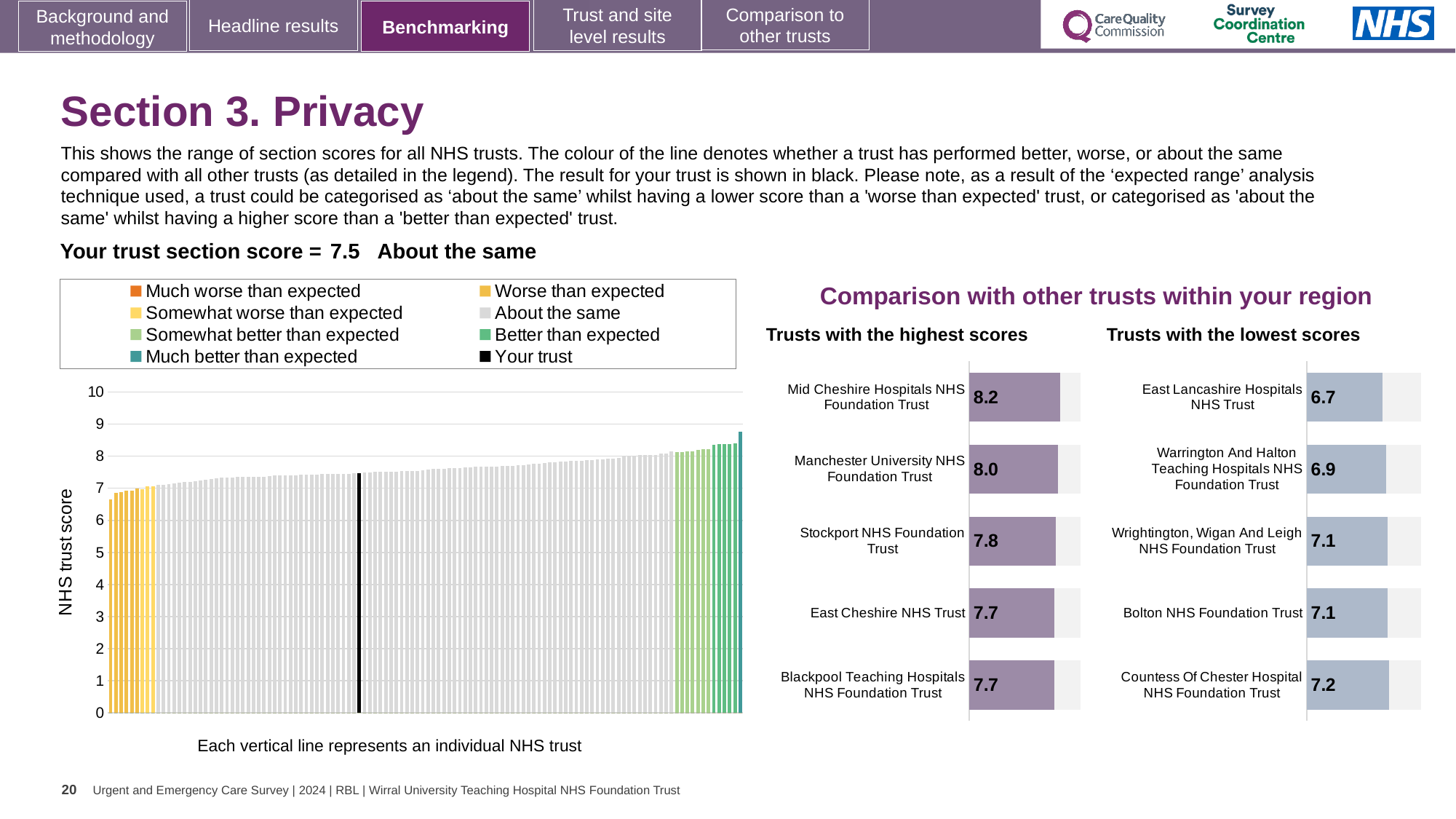
In the 'Trusts with the highest scores' chart, which trust has the highest score? Mid Cheshire Hospitals NHS Foundation Trust In the 'Trusts with the lowest scores' chart, what is the score for Warrington And Halton Teaching Hospitals NHS Foundation Trust? 6.9 In the 'Trusts with the highest scores' chart, what is the difference between the scores of Mid Cheshire Hospitals NHS Foundation Trust and Blackpool Teaching Hospitals NHS Foundation Trust? 0.5 In the 'Trusts with the lowest scores' chart, which has the larger score: Bolton NHS Foundation Trust or Countess Of Chester Hospital NHS Foundation Trust? Countess Of Chester Hospital NHS Foundation Trust In the NHS trust score chart on the left, is the value for the black 'Your trust' bar greater or less than 7? greater In the 'Trusts with the highest scores' chart, how many trusts are shown? 5 In the 'Trusts with the lowest scores' chart, which trust has the lowest score? East Lancashire Hospitals NHS Trust What kind of chart is the NHS trust score chart on the left of the slide? Bar chart In the NHS trust score chart on the left, do the values rise or fall from left to right? Rise In the 'Trusts with the highest scores' chart, what is the score for Mid Cheshire Hospitals NHS Foundation Trust? 8.2 In the 'Trusts with the lowest scores' chart, what is the score for Wrightington, Wigan And Leigh NHS Foundation Trust? 7.1 How many entries does the legend of the NHS trust score chart on the left list? 8